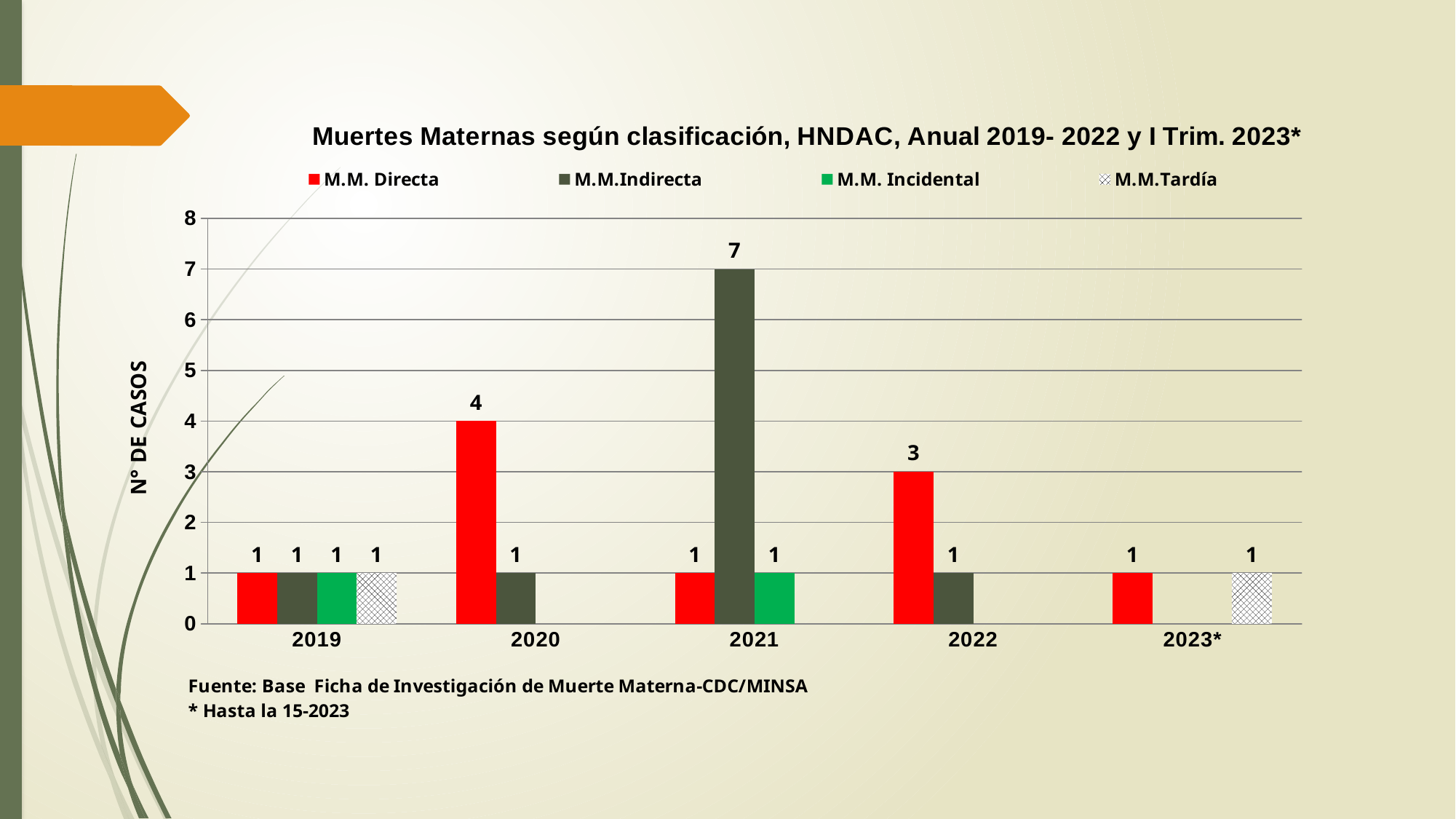
In which year does M.M. Directa reach its highest value? 2020 How many year categories are shown on the x axis? 5 Which is larger in 2022, M.M. Directa or M.M.Indirecta? M.M. Directa How many series does the legend list? 4 What is the value for M.M. Directa in 2022? 3 What is the value for M.M.Indirecta in 2021? 7 What is the value for M.M.Tardía in 2023*? 1 What is the label of the y axis? N° DE CASOS What kind of chart is shown on the slide? Bar chart What is the value for M.M. Directa in 2020? 4 What is the difference between M.M.Indirecta and M.M. Directa in 2021? 6 In which year does M.M.Indirecta reach its highest value? 2021